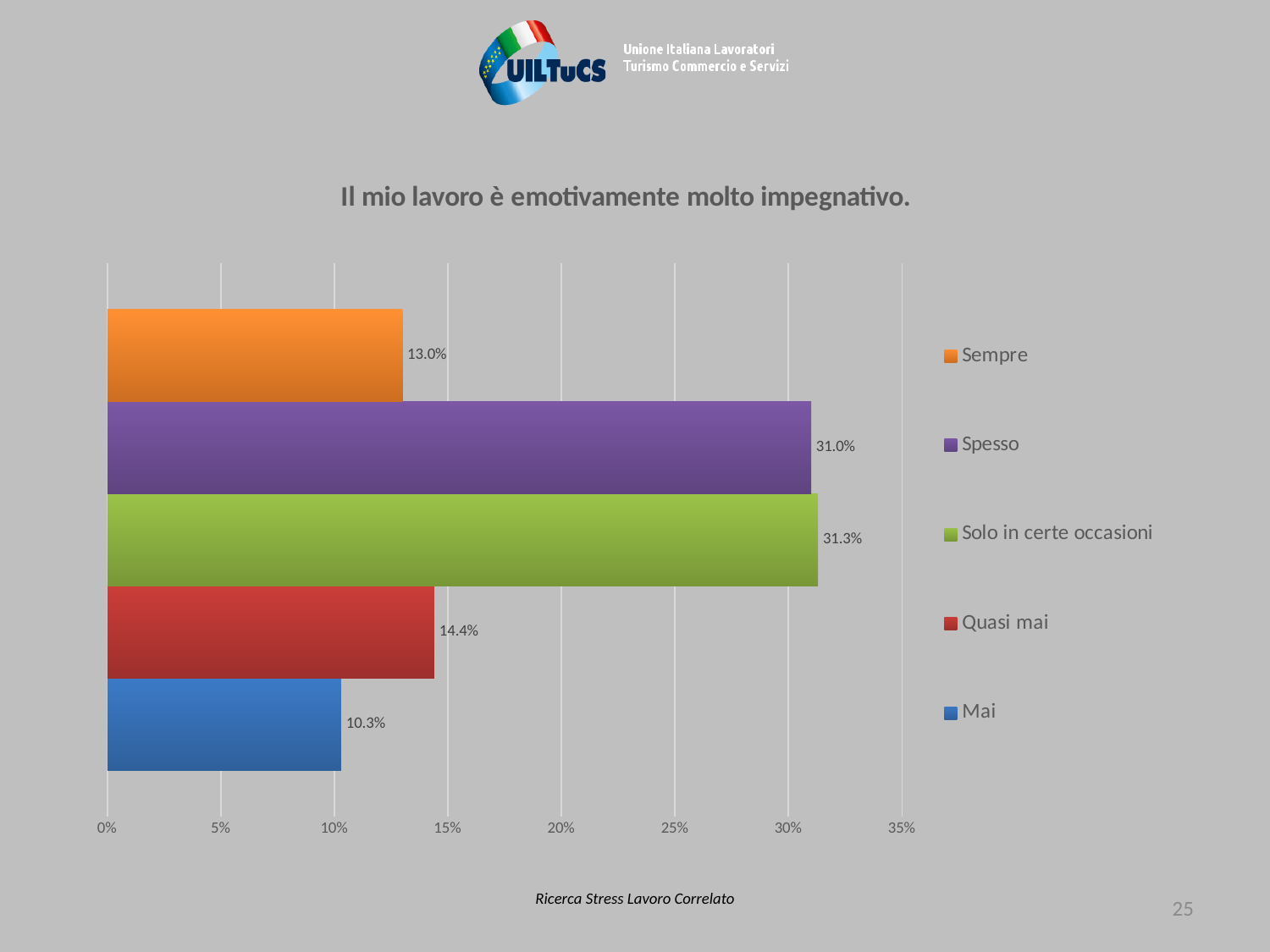
Is the value for Solo in certe occasioni greater or less than 30%? greater How many categories are shown in the chart? 5 What is the value for Quasi mai? 14.4% What is the value for Spesso? 31.0% Which is larger, the value for Sempre or the value for Quasi mai? Quasi mai What is the difference between the values for Quasi mai and Mai? 4.1% What is the title of the chart? Il mio lavoro è emotivamente molto impegnativo. What kind of chart is shown on the slide? bar chart Which category has the lowest value? Mai What is the value for Sempre? 13.0% Which category has the highest value? Solo in certe occasioni What is the value for Mai? 10.3%